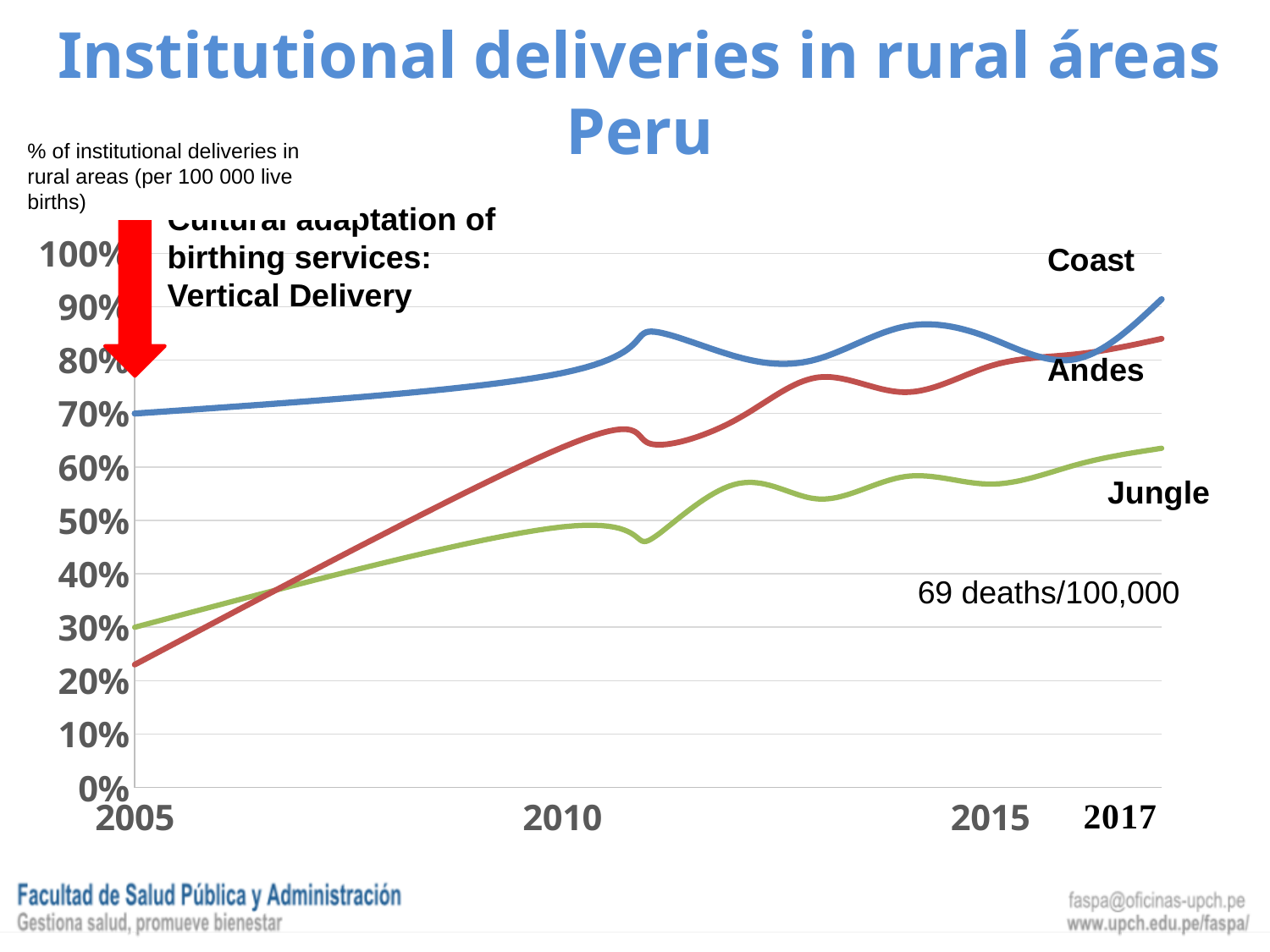
Which region has the highest value in 2017? Coast Which region has the lowest value in 2005? Andes Is the value for Andes in 2005 greater or less than 30%? less Which region has the lowest value in 2017? Jungle How many series (regions) are plotted on the chart? 3 Does the Andes line rise or fall overall from 2005 to 2017? rise What kind of chart is shown on the slide? line chart Is the value for Coast in 2017 greater or less than 90%? greater Is the value for Jungle in 2017 greater or less than 60%? greater What is the value for Coast in 2005? 70% What colour is the Jungle line on the chart? green In 2017, which is larger: the value for Andes or the value for Jungle? Andes